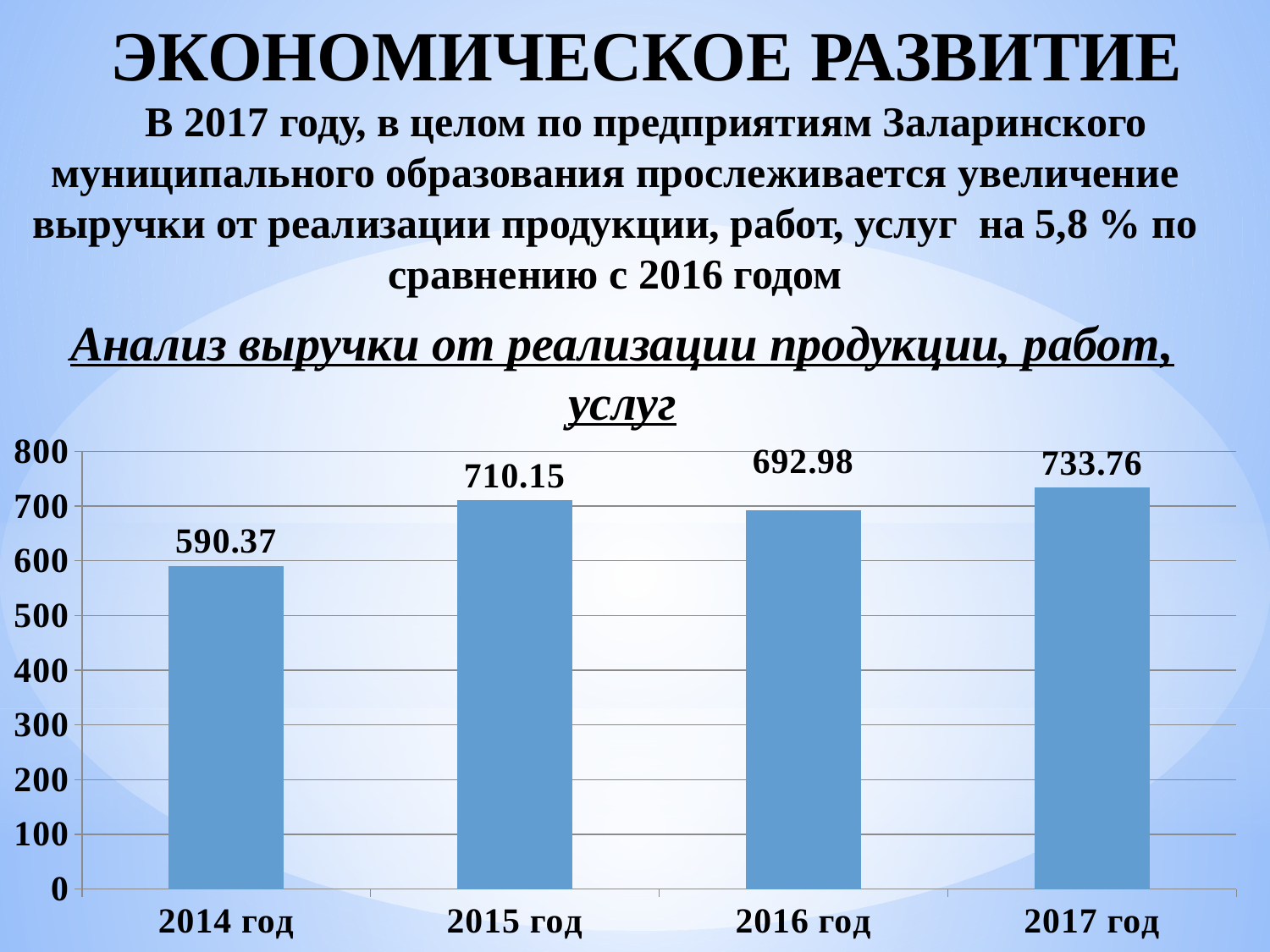
What kind of chart is shown on the slide? bar chart What is the difference between the values for 2015 год and 2014 год? 119.78 Is the value for 2014 год greater or less than 600? less What is the value for 2016 год? 692.98 What is the value for 2014 год? 590.37 What is the difference between the values for 2017 год and 2016 год? 40.78 Which year has the highest value? 2017 год What is the value for 2017 год? 733.76 How many years are shown on the chart? 4 Which is larger, the value for 2015 год or the value for 2016 год? 2015 год What is the title of the chart? Анализ выручки от реализации продукции, работ, услуг Which year has the lowest value? 2014 год